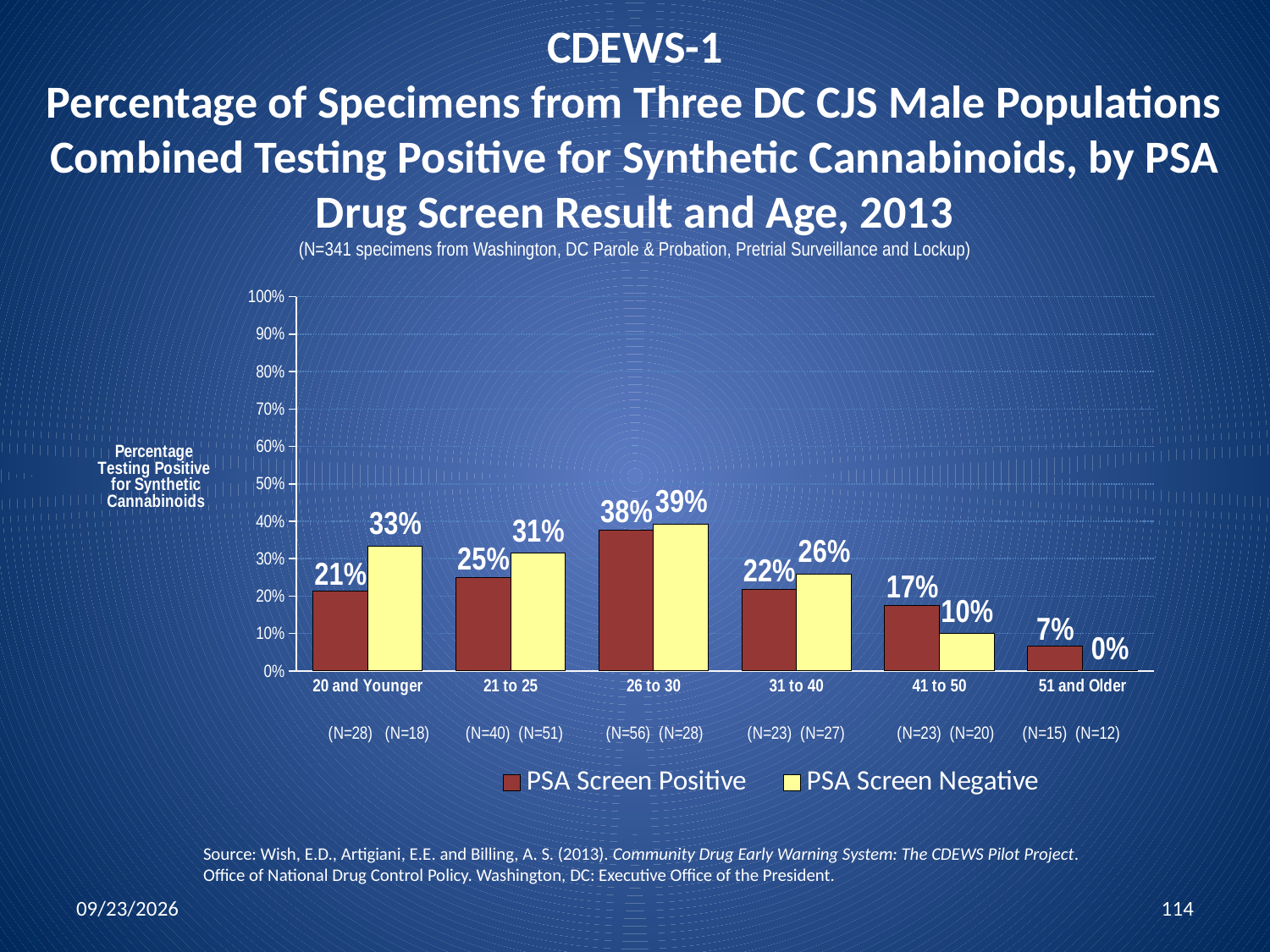
What is the difference between the PSA Screen Negative and PSA Screen Positive values for the 20 and Younger age group? 12% What is the value for PSA Screen Negative in the 51 and Older age group? 0% How many series does the legend list? 2 What kind of chart is shown on the slide? Bar chart Which age group has the highest PSA Screen Positive percentage? 26 to 30 How many age groups are shown on the x axis? 6 What percentage of PSA Screen Positive specimens in the 26 to 30 age group tested positive for synthetic cannabinoids? 38% Is the PSA Screen Negative value for 26 to 30 greater or less than 30%? greater What is the value for PSA Screen Negative in the 20 and Younger age group? 33% Which age group has the lowest PSA Screen Negative percentage? 51 and Older In the 41 to 50 age group, which is larger: PSA Screen Positive or PSA Screen Negative? PSA Screen Positive Do the PSA Screen Positive values rise or fall from the 26 to 30 age group to the 51 and Older age group? Fall